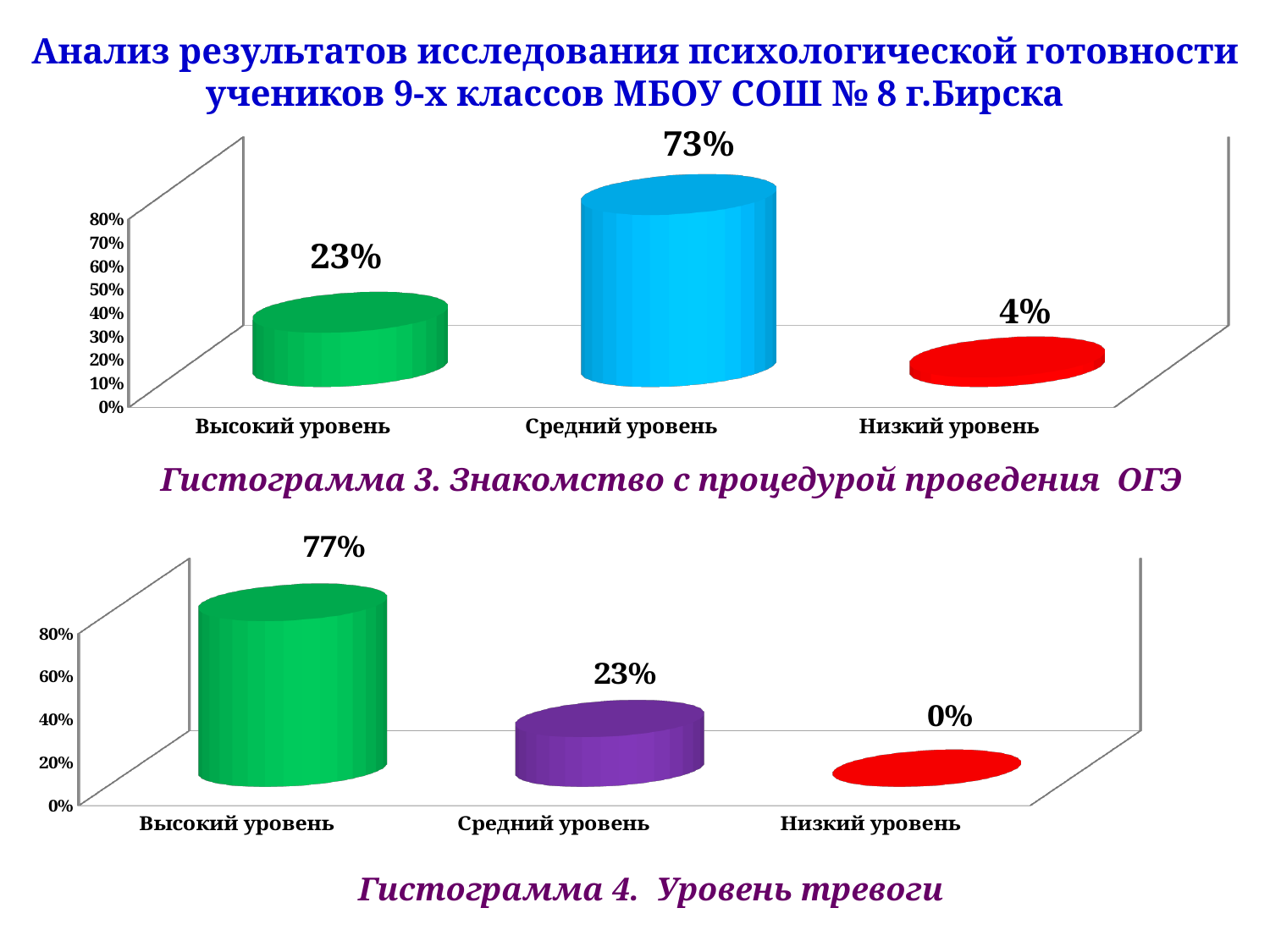
What kind of chart is the bottom chart (Гистограмма 4)? Bar chart In the bottom chart (Гистограмма 4), which category has the lowest value? Низкий уровень In the bottom chart (Гистограмма 4), what is the difference between Высокий уровень and Средний уровень? 54% In the top chart (Гистограмма 3. Знакомство с процедурой проведения ОГЭ), what is the value for Средний уровень? 73% In the bottom chart (Гистограмма 4), what is the value for Низкий уровень? 0% In the top chart (Гистограмма 3), what is the difference between Средний уровень and Высокий уровень? 50% In the top chart (Гистограмма 3), which category has the highest value? Средний уровень In the top chart (Гистограмма 3), what is the value for Низкий уровень? 4% In the top chart (Гистограмма 3), what is the value for Высокий уровень? 23% In the bottom chart (Гистограмма 4. Уровень тревоги), what is the value for Высокий уровень? 77% In the bottom chart (Гистограмма 4), which is larger, Высокий уровень or Средний уровень? Высокий уровень How many categories are shown in the top chart (Гистограмма 3)? 3